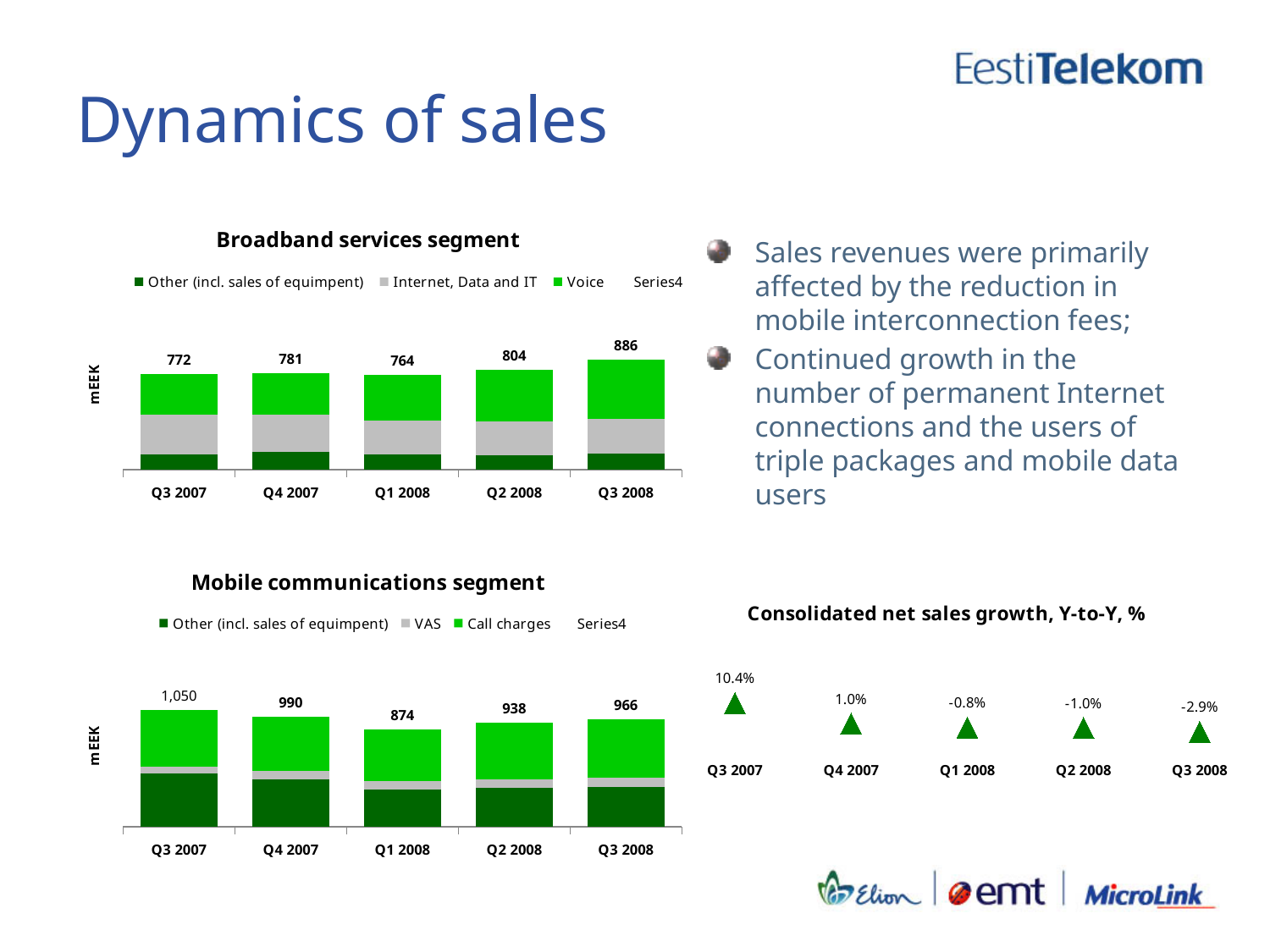
In the Mobile communications segment chart, what is the difference between the totals for Q3 2007 and Q4 2007? 60 In the Mobile communications segment chart, what is the total value labelled for Q3 2007? 1,050 In the Broadband services segment chart, which quarter has the lowest total? Q1 2008 In the Broadband services segment chart, what is the total value labelled for Q3 2008? 886 In the Consolidated net sales growth chart, which quarter has the highest value? Q3 2007 In the Broadband services segment chart, what is the difference between the totals for Q3 2008 and Q3 2007? 114 How many quarters are shown on the x axis of the Broadband services segment chart? 5 In the Mobile communications segment chart, which quarter has the lowest total? Q1 2008 In the Mobile communications segment chart, which is larger, the total for Q2 2008 or Q3 2008? Q3 2008 What type of chart is the Mobile communications segment chart? stacked bar chart In the Consolidated net sales growth chart, do the values rise or fall from Q3 2007 to Q3 2008? fall In the Consolidated net sales growth chart, what is the value for Q3 2008? -2.9%